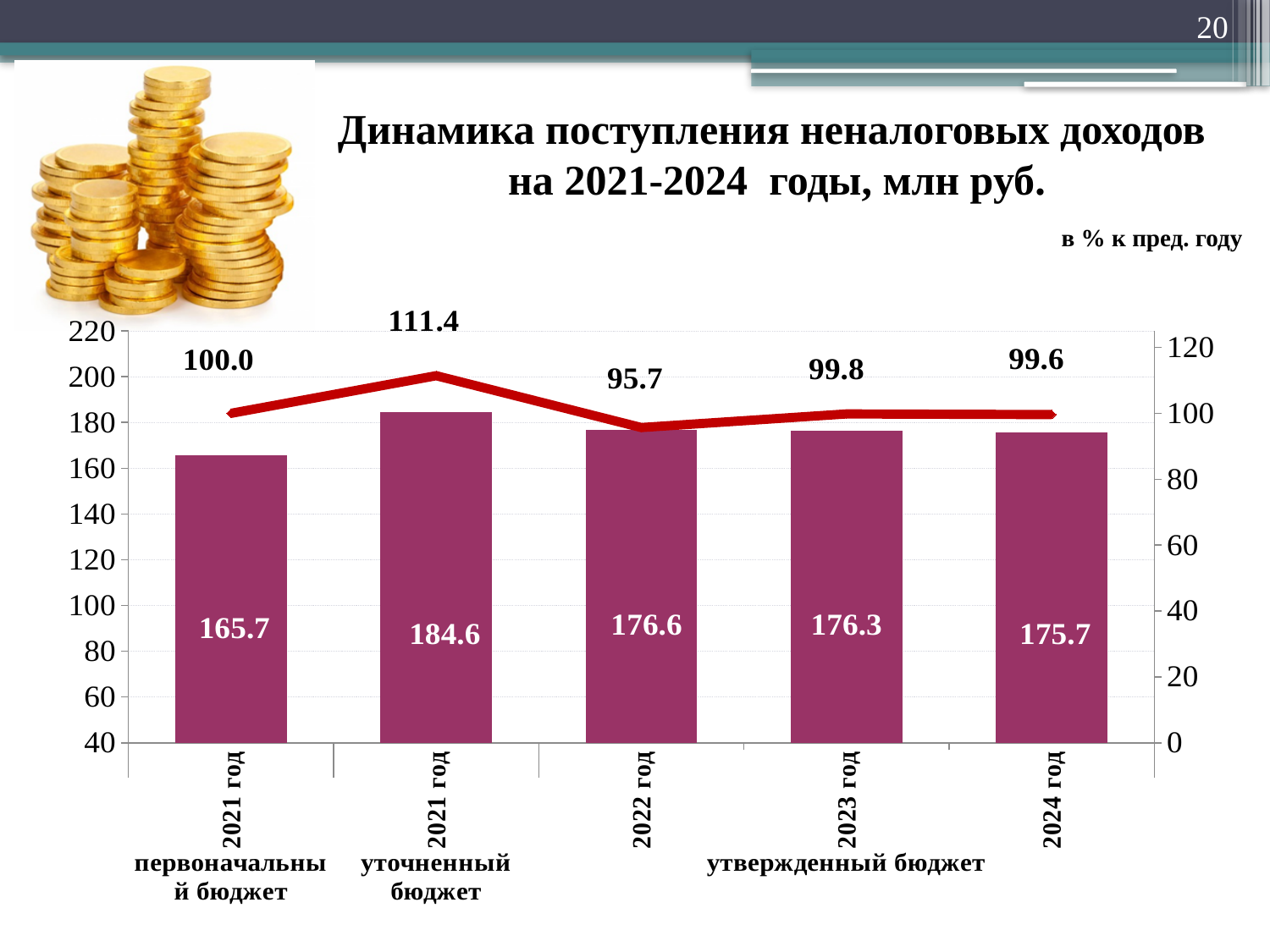
What is the difference between the bar values for 2021 год уточненный бюджет and 2021 год первоначальный бюджет? 18.9 What is the value shown on the bar for 2024 год? 175.7 What percentage to the previous year is shown on the line for 2021 год, уточненный бюджет? 111.4 What is the value shown on the bar for 2021 год, уточненный бюджет? 184.6 Which category has the highest bar value? 2021 год, уточненный бюджет How many bars are plotted on the chart? 5 Do the bar values rise or fall from 2022 год to 2024 год? fall What is the non-tax revenue value (млн руб.) shown on the bar for 2021 год, первоначальный бюджет? 165.7 Which category has the lowest bar value? 2021 год, первоначальный бюджет What colour is the line showing % к пред. году? red What percentage to the previous year (в % к пред. году) is shown on the line for 2022 год? 95.7 Which is larger: the bar value for 2022 год or for 2023 год? 2022 год